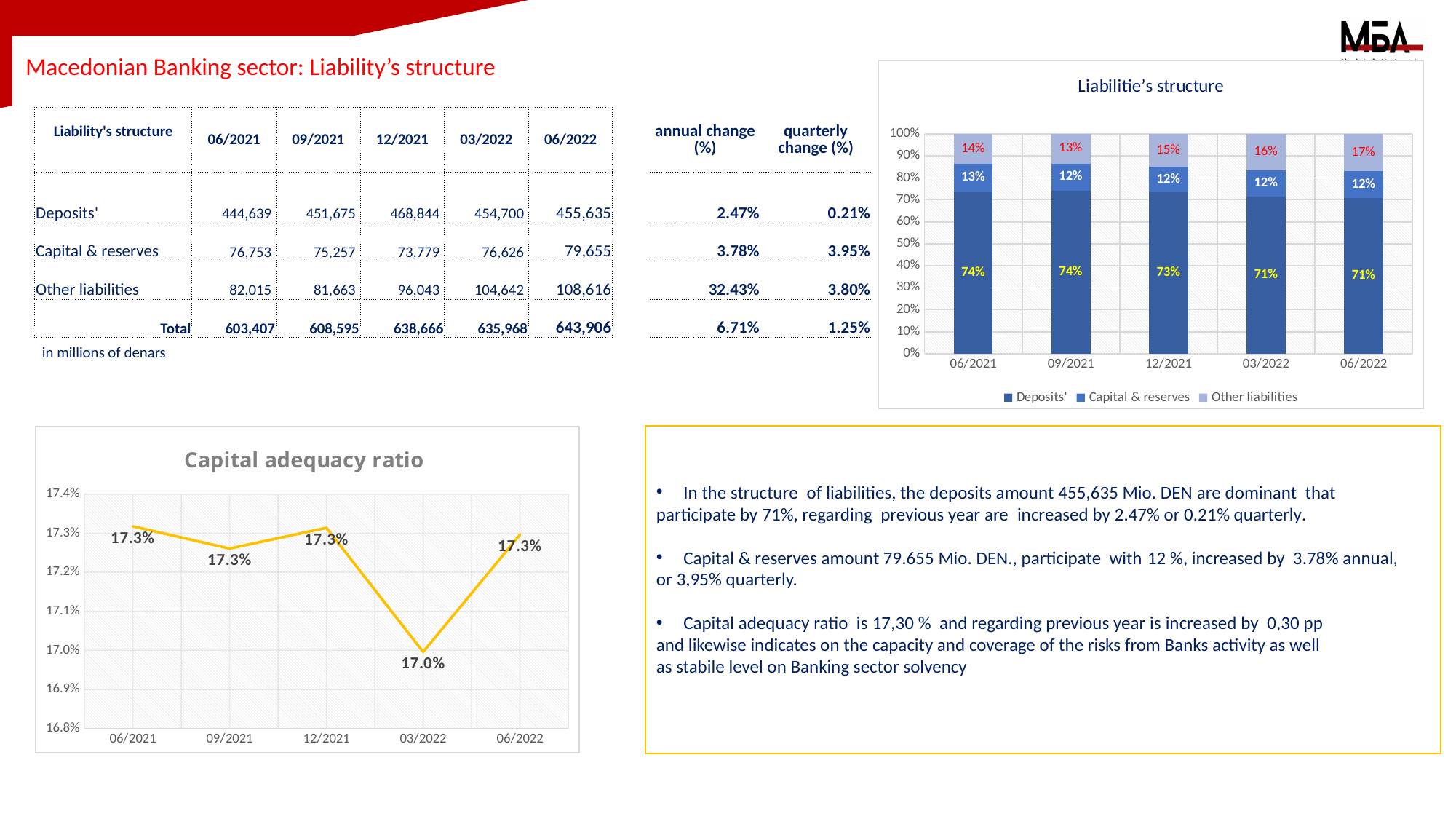
In the 'Liabilitie's structure' chart, what share do Deposits' have in 06/2022? 71% In the 'Liabilitie's structure' chart, how many periods are shown on the x axis? 5 In the 'Liabilitie's structure' chart, what share do Other liabilities have in 12/2021? 15% In the 'Capital adequacy ratio' chart, is the value for 06/2021 greater or less than 17.2%? greater In the 'Liabilitie's structure' chart, how many series does the legend list? 3 In the 'Capital adequacy ratio' chart, what is the value for 03/2022? 17.0% In the 'Liabilitie's structure' chart, what share do Capital & reserves have in 06/2021? 13% In the 'Liabilitie's structure' chart, by how many percentage points did the Deposits' share fall from 06/2021 to 06/2022? 3 percentage points In the 'Liabilitie's structure' chart, in which period is the Other liabilities share highest? 06/2022 What kind of chart is the 'Capital adequacy ratio' chart? Line chart In the 'Capital adequacy ratio' chart, which period has the lowest value? 03/2022 What kind of chart is the 'Liabilitie's structure' chart? Stacked bar chart